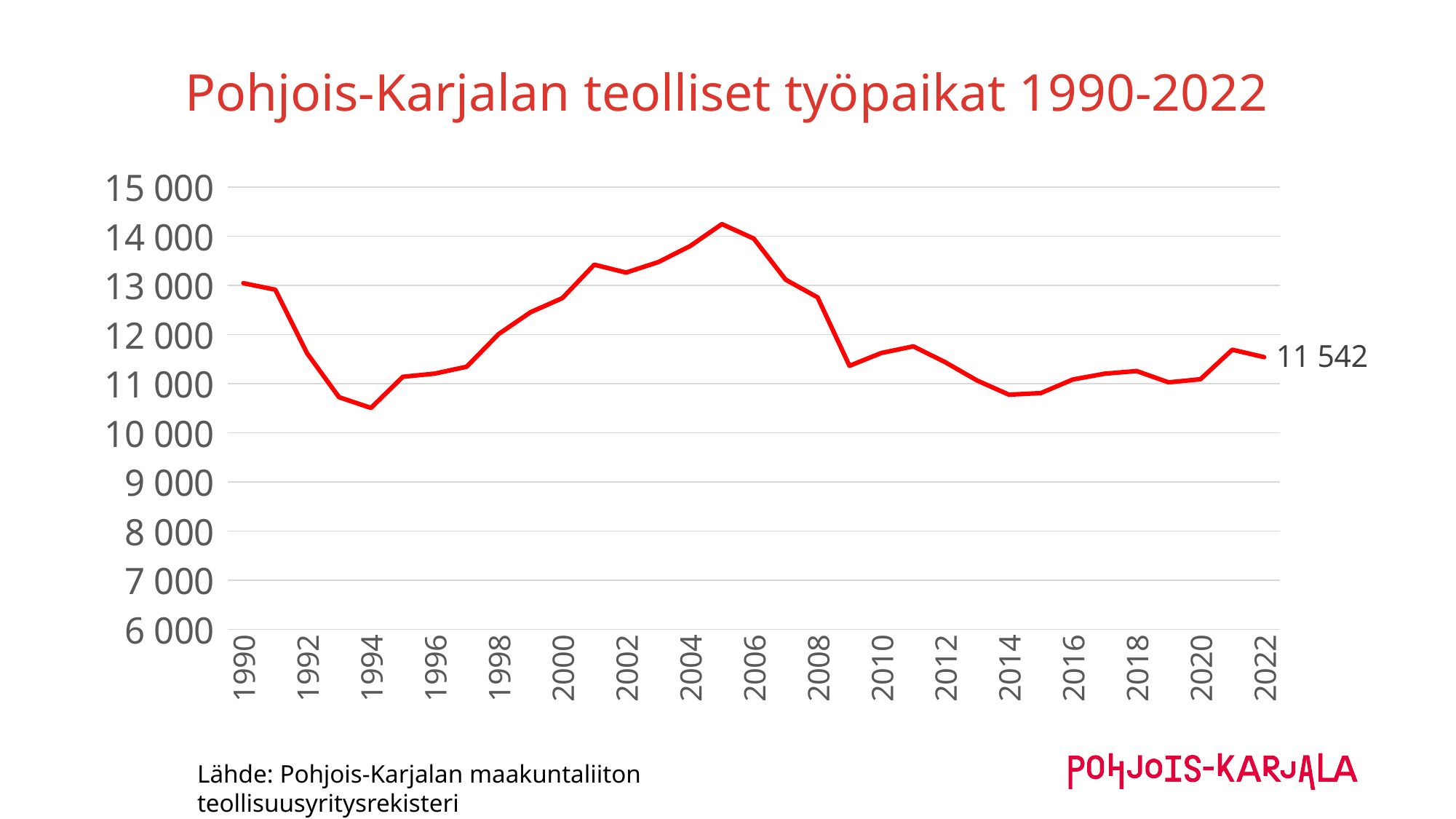
Is the value for 2008 greater or less than 13 000? less Do the values rise or fall between 2005 and 2009? fall Which year has the larger value, 1990 or 2022? 1990 In which year does the line reach its lowest value? 1994 In which year does the line reach its highest value? 2005 Do the values rise or fall between 1994 and 2001? rise What is the title of the chart? Pohjois-Karjalan teolliset työpaikat 1990-2022 Is the value for 2005 greater or less than 14 000? greater Is the value for 1994 greater or less than 11 000? less What kind of chart is shown on the slide? line chart Which year has the larger value, 2005 or 2014? 2005 What is the value shown for 2022? 11 542